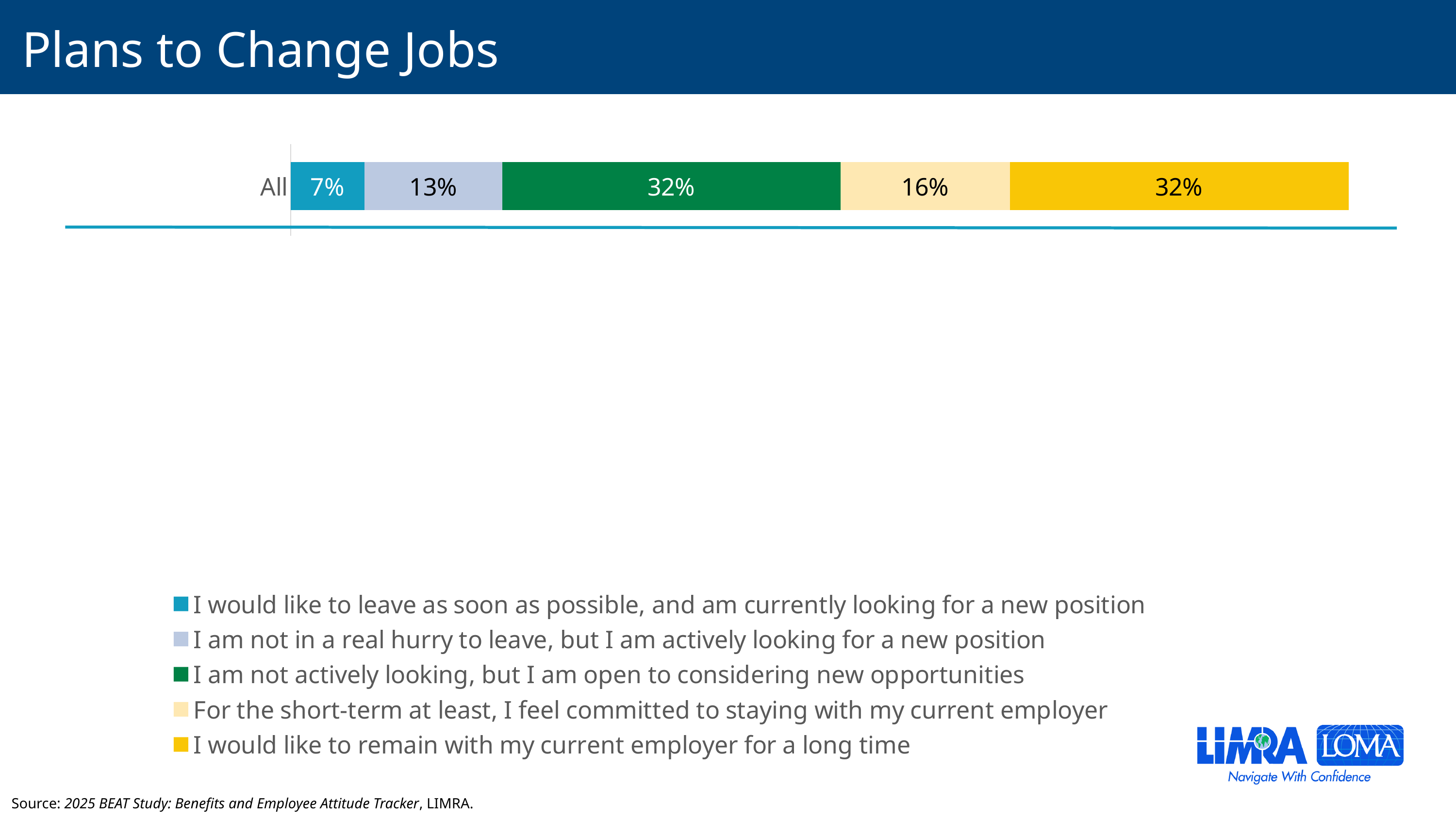
What percentage of respondents said they are not in a real hurry to leave but are actively looking for a new position? 13% What percentage of respondents said they would like to remain with their current employer for a long time? 32% What percentage of respondents said they are not actively looking but are open to considering new opportunities? 32% What is the difference between the share who are not in a real hurry to leave but actively looking (13%) and the share who would like to leave as soon as possible (7%)? 6 percentage points What percentage of respondents said they would like to leave as soon as possible and are currently looking for a new position? 7% How many series does the legend list? 5 Which is larger: the share who feel committed to staying for the short-term, or the share who are not in a real hurry to leave but actively looking? The share who feel committed to staying for the short-term (16%) What is the difference between the share who are not actively looking but open to new opportunities and the share who feel committed to staying for the short-term? 16 percentage points What is the total of all segments in the 'All' bar? 100% Which response has the smallest share in the 'All' bar? I would like to leave as soon as possible, and am currently looking for a new position What percentage of respondents said that for the short-term at least they feel committed to staying with their current employer? 16% What kind of chart is shown on the slide? Stacked horizontal bar chart